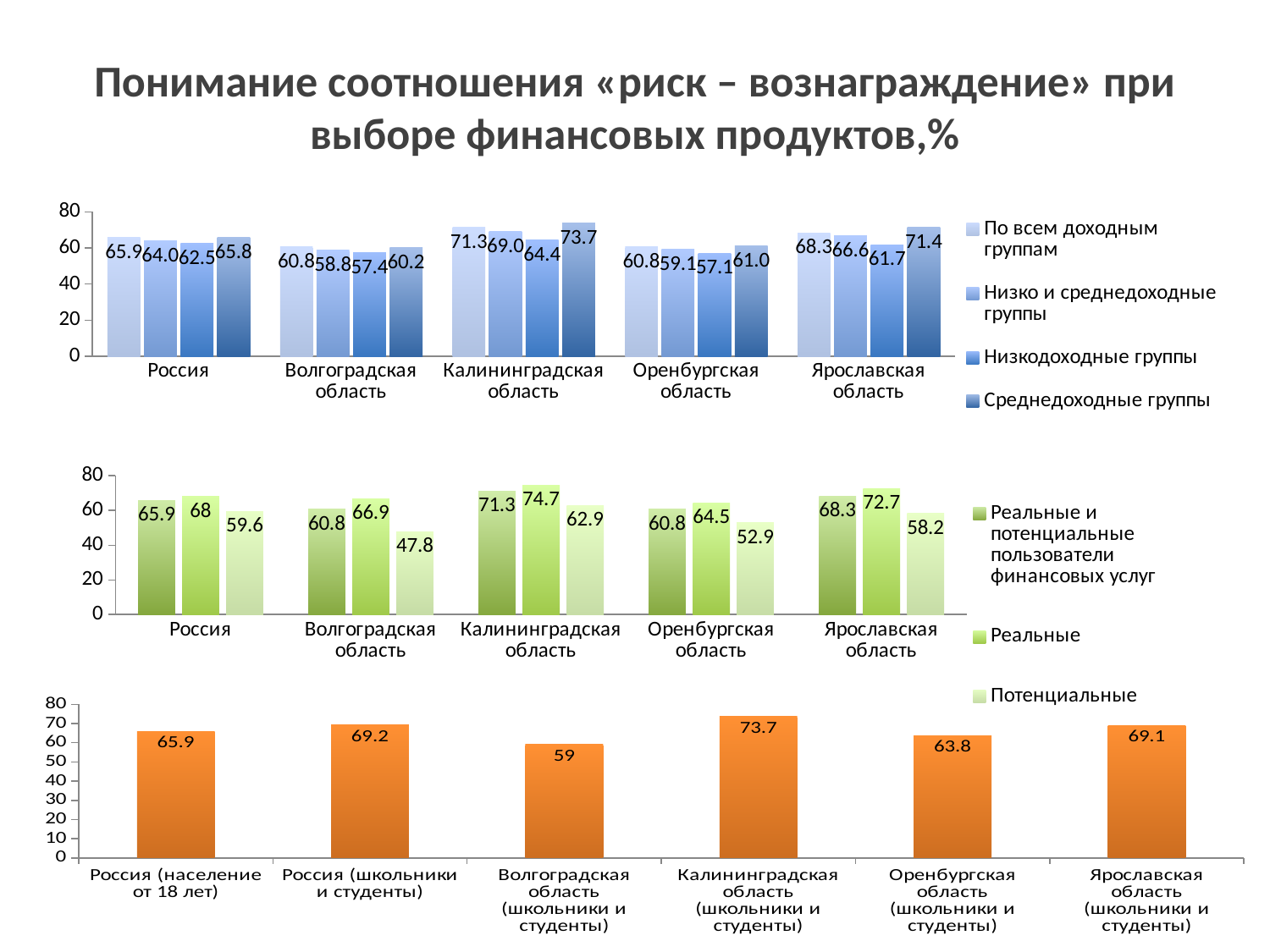
What type of chart is the bottom chart? Bar chart In the top chart, what is the value for Среднедоходные группы in Калининградская область? 73.7 In the middle chart, what is the difference between Реальные and Потенциальные for Ярославская область? 14.5 In the top chart, what is the value for Низкодоходные группы in Волгоградская область? 57.4 How many series does the legend of the top chart list? 4 In the bottom chart, which is larger: the value for Россия (школьники и студенты) or Оренбургская область (школьники и студенты)? Россия (школьники и студенты) In the top chart, which region has the lowest value for Низкодоходные группы? Оренбургская область In the middle chart, what is the value for Потенциальные in Волгоградская область? 47.8 In the bottom chart, what is the value for Волгоградская область (школьники и студенты)? 59 In the bottom chart, which category has the highest value? Калининградская область (школьники и студенты) In the middle chart, which region has the highest value for Реальные? Калининградская область How many regions (categories) are shown on the x axis of the middle chart? 5